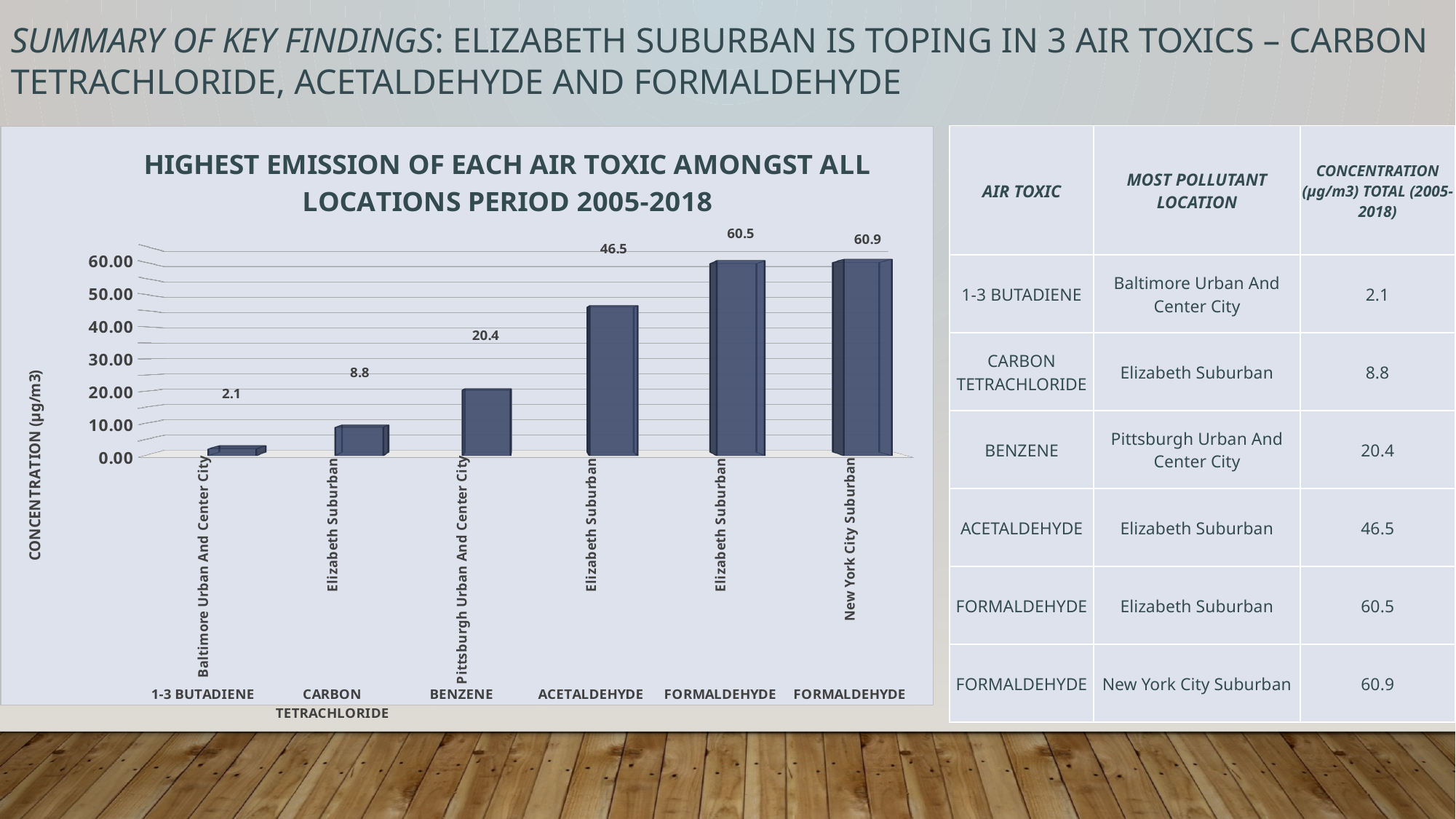
What kind of chart is shown? Bar chart What is the value for Carbon Tetrachloride (Elizabeth Suburban)? 8.8 How many bars are plotted in the chart? 6 What is the value for Benzene (Pittsburgh Urban And Center City)? 20.4 What is the value for 1-3 Butadiene (Baltimore Urban And Center City)? 2.1 Which bar has the highest value? Formaldehyde (New York City Suburban) Is the value for Acetaldehyde greater or less than 40.00? greater Which is larger: the Carbon Tetrachloride value or the Benzene value? Benzene What is the difference between the Acetaldehyde value and the Benzene value? 26.1 Which bar has the lowest value? 1-3 Butadiene (Baltimore Urban And Center City) What is the label of the vertical axis? CONCENTRATION (µg/m3) What is the value for Acetaldehyde (Elizabeth Suburban)? 46.5